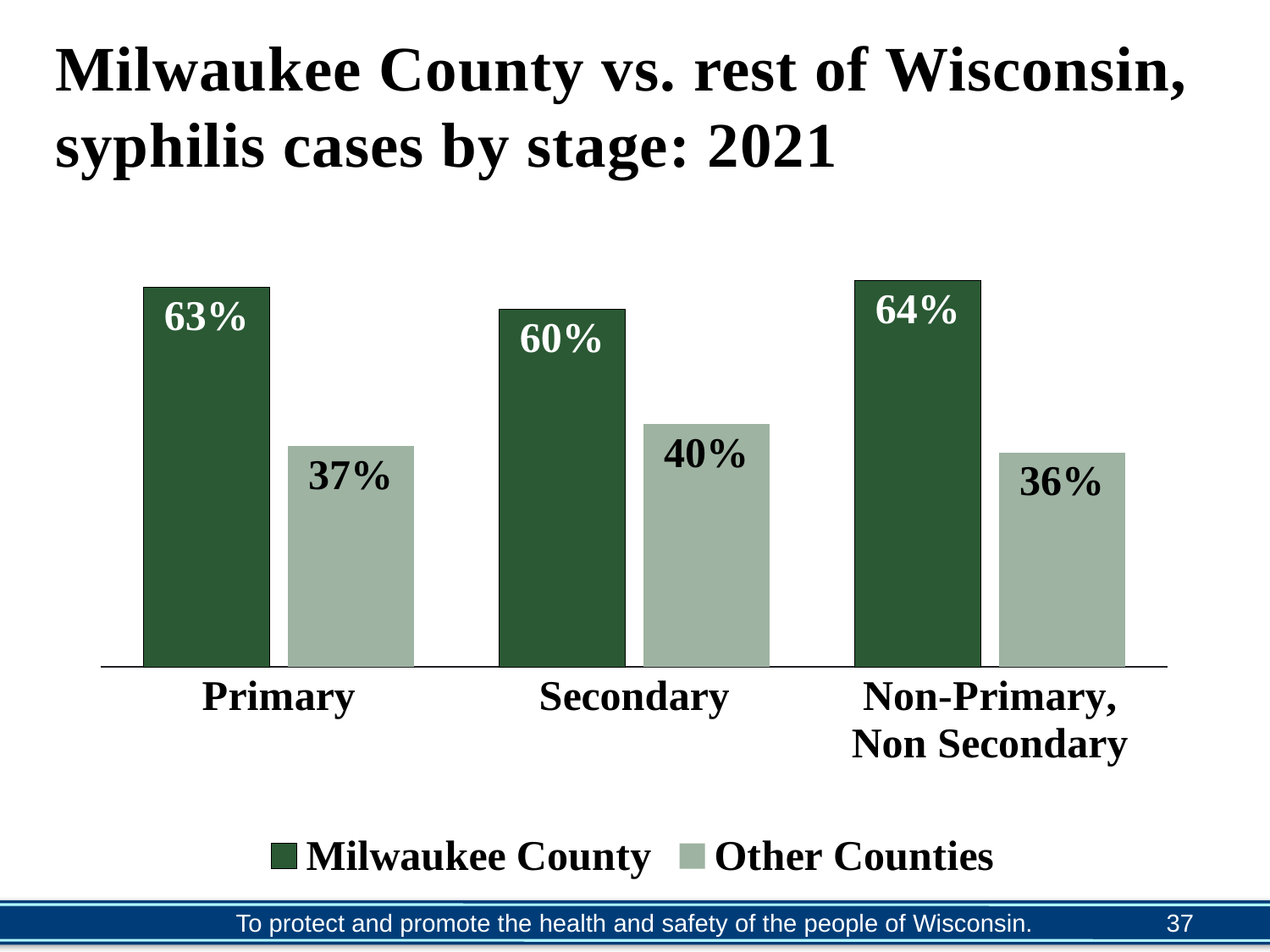
How many stage categories are shown on the x axis? 3 What kind of chart is shown on the slide? Bar chart Which stage has the highest value for Milwaukee County? Non-Primary, Non Secondary What is the value for Milwaukee County in the Primary stage? 63% Which stage has the lowest value for Other Counties? Non-Primary, Non Secondary What is the value for Other Counties in the Primary stage? 37% In the Primary stage, which is larger: Milwaukee County or Other Counties? Milwaukee County What is the value for Milwaukee County in the Non-Primary, Non Secondary stage? 64% What is the difference between the Milwaukee County and Other Counties values in the Secondary stage? 20% How many series does the legend list? 2 What are the two series named in the legend? Milwaukee County and Other Counties What is the value for Other Counties in the Secondary stage? 40%